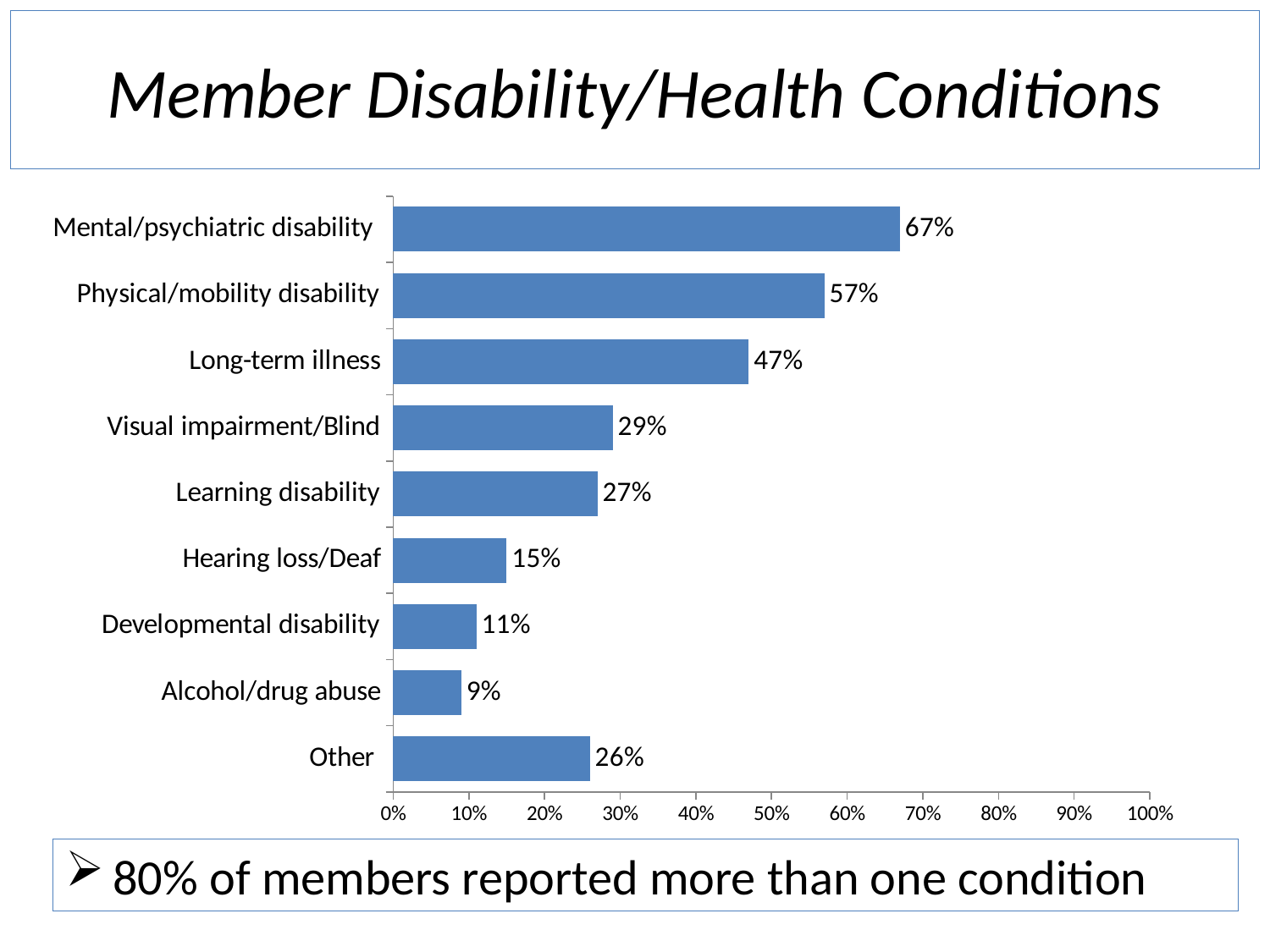
What is the value shown for Long-term illness? 47% What percentage of members reported a mental/psychiatric disability? 67% Is the value for Developmental disability greater or less than 20%? less Which condition has the highest percentage? Mental/psychiatric disability Which condition has the lowest percentage? Alcohol/drug abuse How many conditions are listed on the chart? 9 Which is larger, the value for Visual impairment/Blind or the value for Learning disability? Visual impairment/Blind What is the title of the slide containing the chart? Member Disability/Health Conditions What percentage is shown for Hearing loss/Deaf? 15% What kind of chart is shown on the slide? Bar chart What is the difference between the percentages for Physical/mobility disability and Long-term illness? 10% What is the difference between the values for Other and Alcohol/drug abuse? 17%